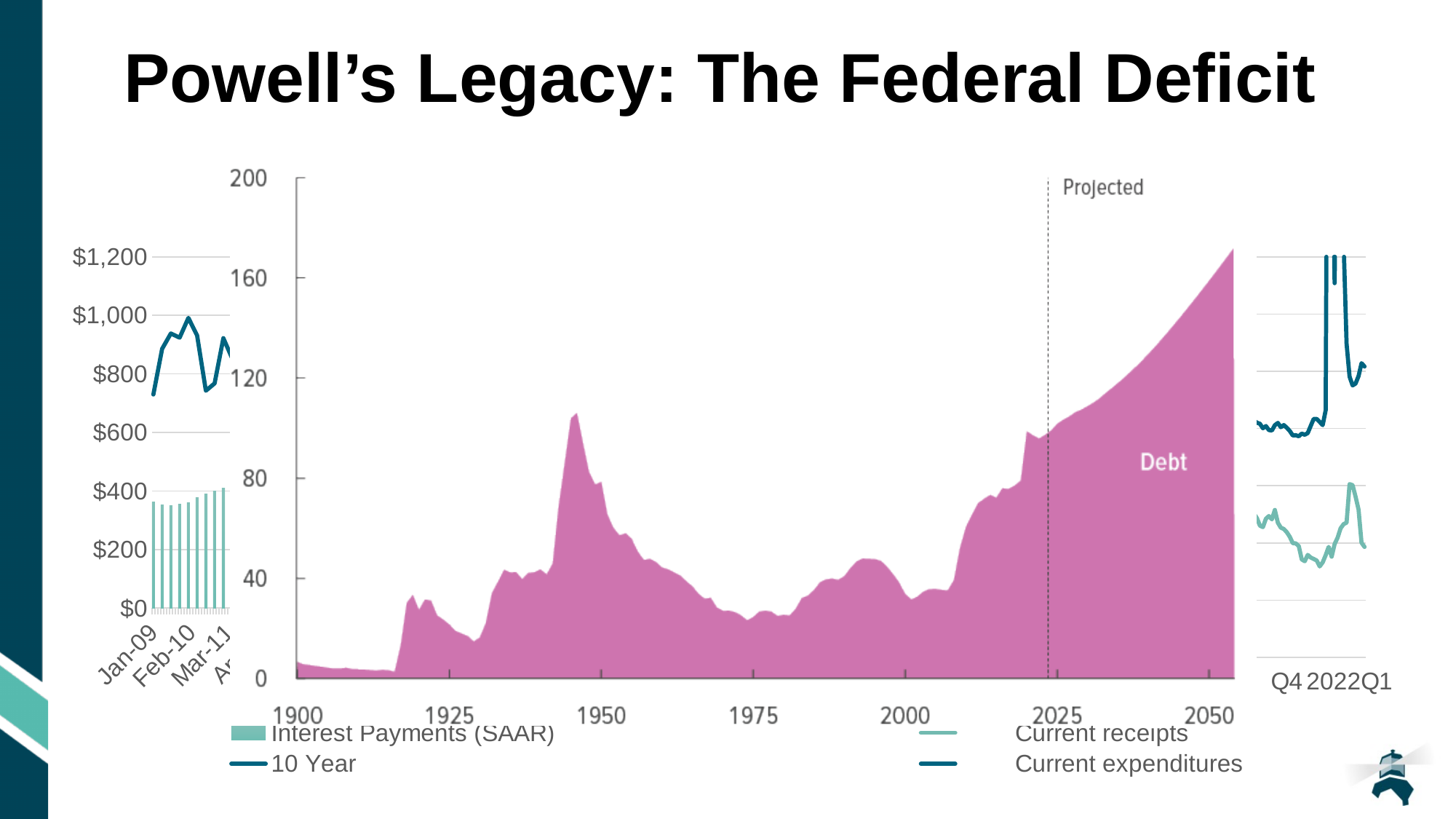
On the central Debt chart, is the value in 1925 greater or less than 40? less What kind of chart is the large central chart labelled "Debt"? area chart On the central Debt chart, is the value in 1975 greater or less than 40? less On the central Debt chart, is the value in 2050 greater or less than 120? greater What is the highest tick shown on the y axis of the central Debt chart? 200 On the central Debt chart, is the value at the right end of the projection (around 2050) higher or lower than the peak around 1946? higher On the central Debt chart, does the value rise or fall between 2025 and 2050? rise How many series does the legend at the bottom of the slide list? 4 On the central Debt chart, what label appears next to the dashed vertical line near 2025? Projected On the central Debt chart, does the value rise or fall between 1946 and 1975? fall